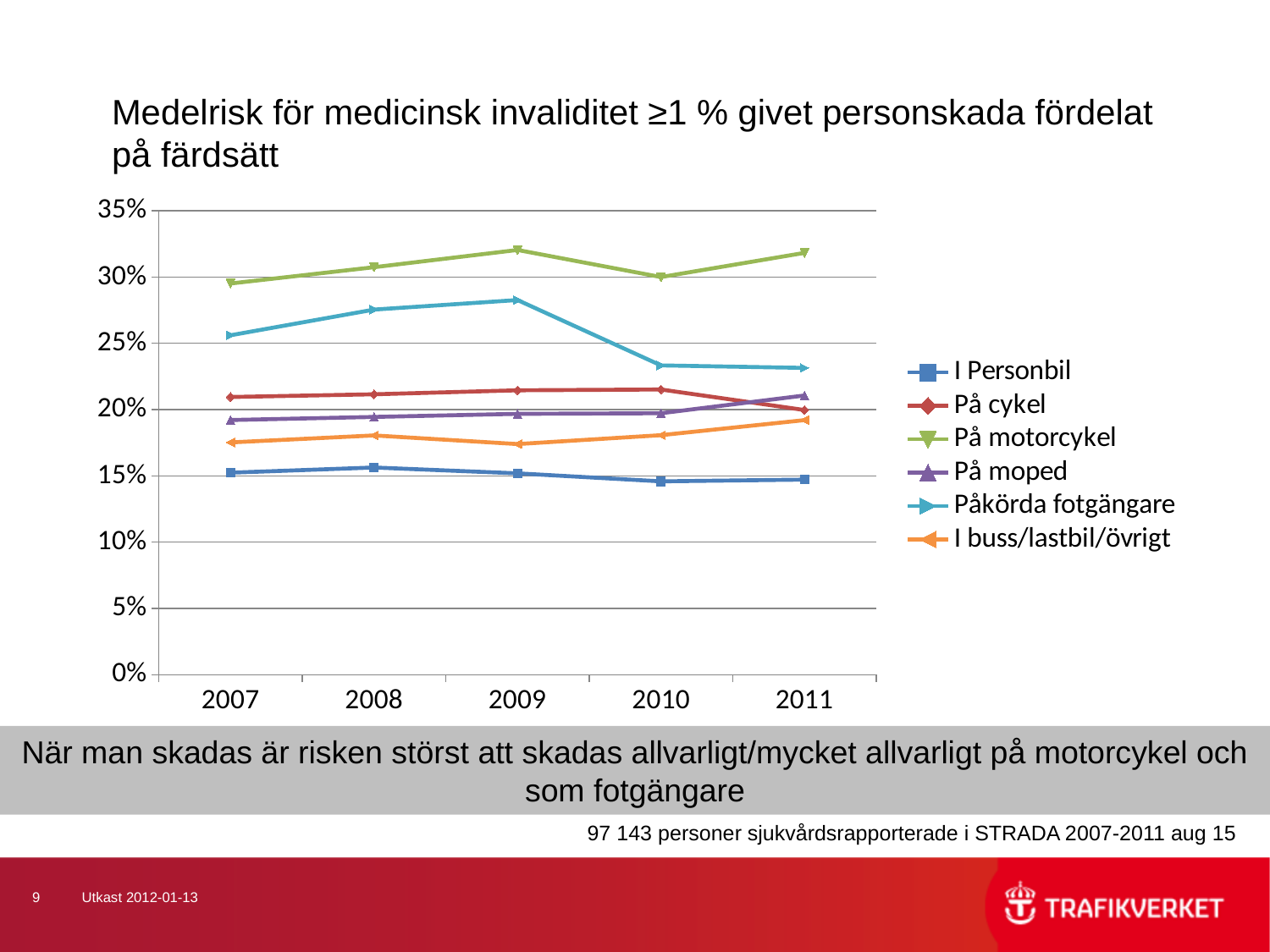
How many years are shown on the x axis? 5 Is the value for På motorcykel in 2009 greater or less than 30%? greater Does the value for Påkörda fotgängare rise or fall from 2009 to 2010? fall In 2008, which is larger: the value for Påkörda fotgängare or the value for På cykel? Påkörda fotgängare Which series is drawn with the green line? På motorcykel Which series has the highest value in 2009? På motorcykel What kind of chart is shown on the slide? line chart Does the value for På moped rise or fall from 2010 to 2011? rise Is the value for Påkörda fotgängare in 2010 greater or less than 25%? less Is the value for I Personbil in 2010 greater or less than 15%? less How many series does the legend list? 6 Which series has the lowest value in 2011? I Personbil